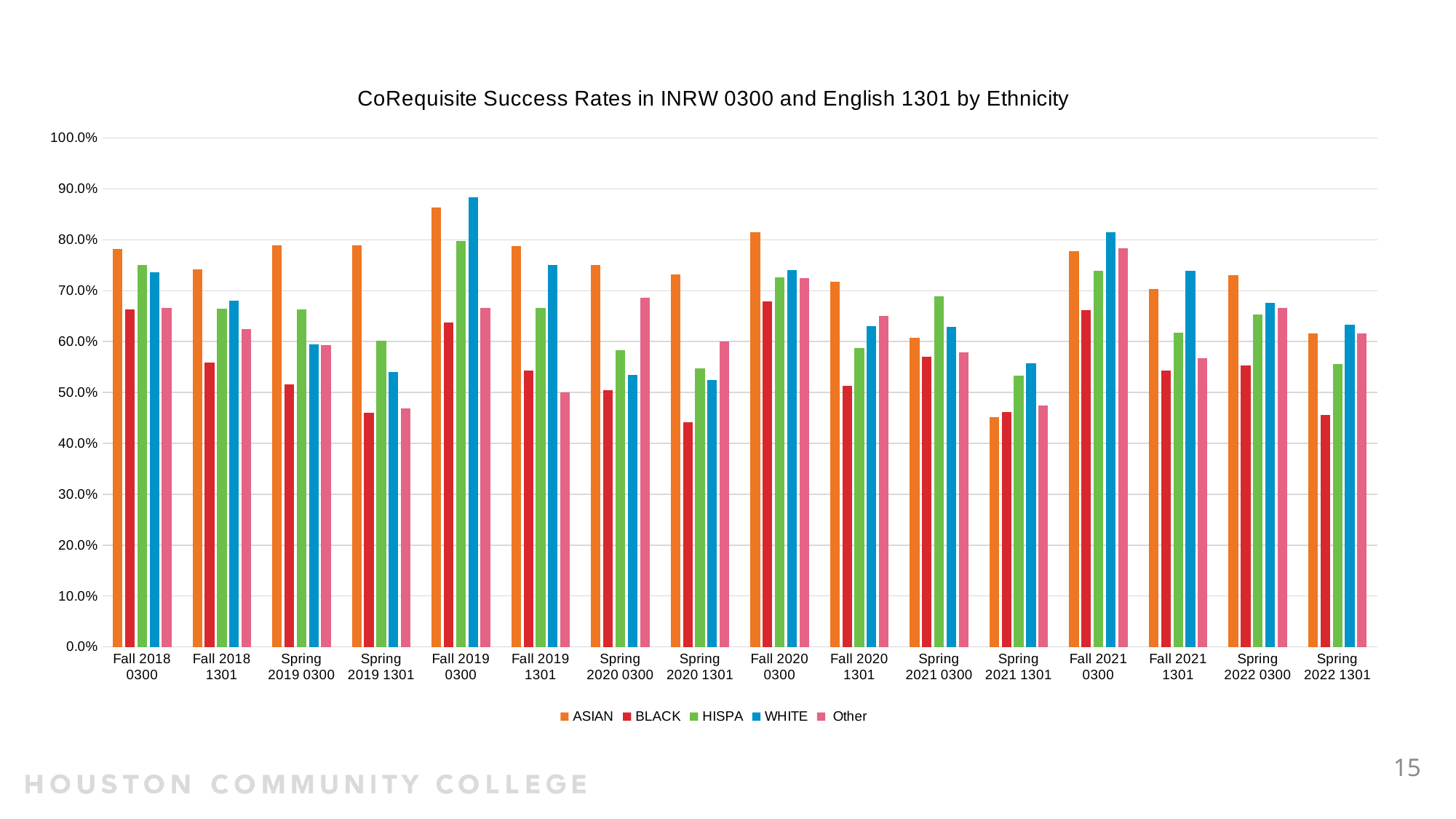
What kind of chart is shown on the slide? bar chart How many term/course categories are shown along the x axis? 16 Which ethnicity has the lowest success rate in Fall 2020 0300? BLACK How many series does the legend list? 5 What is the title of the chart? CoRequisite Success Rates in INRW 0300 and English 1301 by Ethnicity In Fall 2019 1301, which is larger: the WHITE value or the BLACK value? WHITE Which series is shown in blue in the legend? WHITE Is the BLACK value for Spring 2020 1301 greater or less than 50.0%? less Is the WHITE value for Fall 2019 0300 greater or less than 80.0%? greater Is the ASIAN value for Spring 2021 1301 greater or less than 50.0%? less Which ethnicity has the highest success rate in Fall 2020 0300? ASIAN